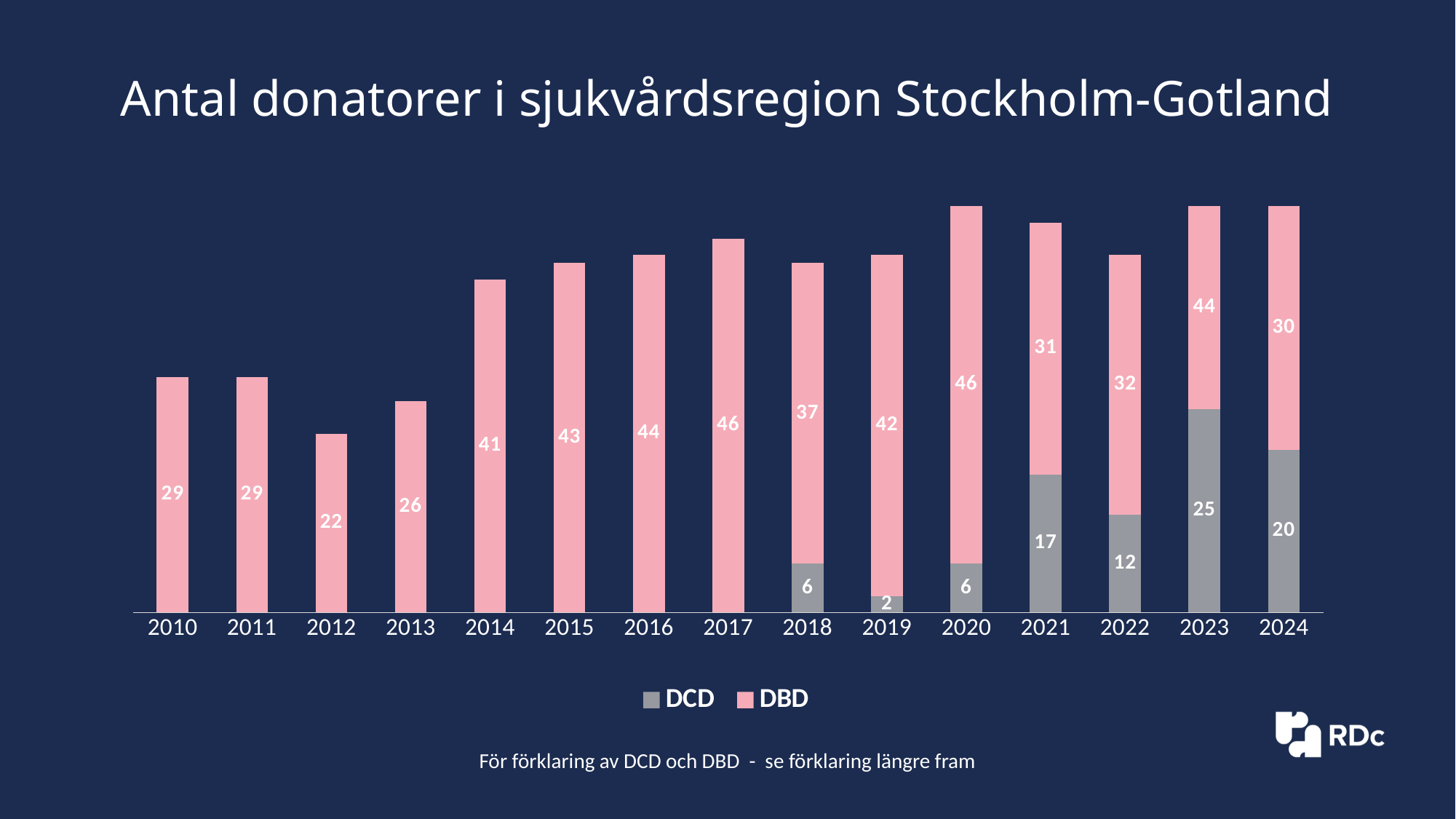
How many series does the legend list? 2 What kind of chart is shown on the slide? Stacked bar chart What is the DCD value for 2021? 17 Which year has the lowest DBD value? 2012 What is the DBD value for 2017? 46 Which year has the highest DCD value? 2023 What is the difference between the DCD values for 2021 and 2022? 5 Is the DCD value for 2021 larger than the DCD value for 2019? Yes Which colour represents DCD in the legend? Grey What is the total number of donors (DCD plus DBD) for 2018? 43 How many years are shown on the x axis? 15 What is the DBD value for 2012? 22